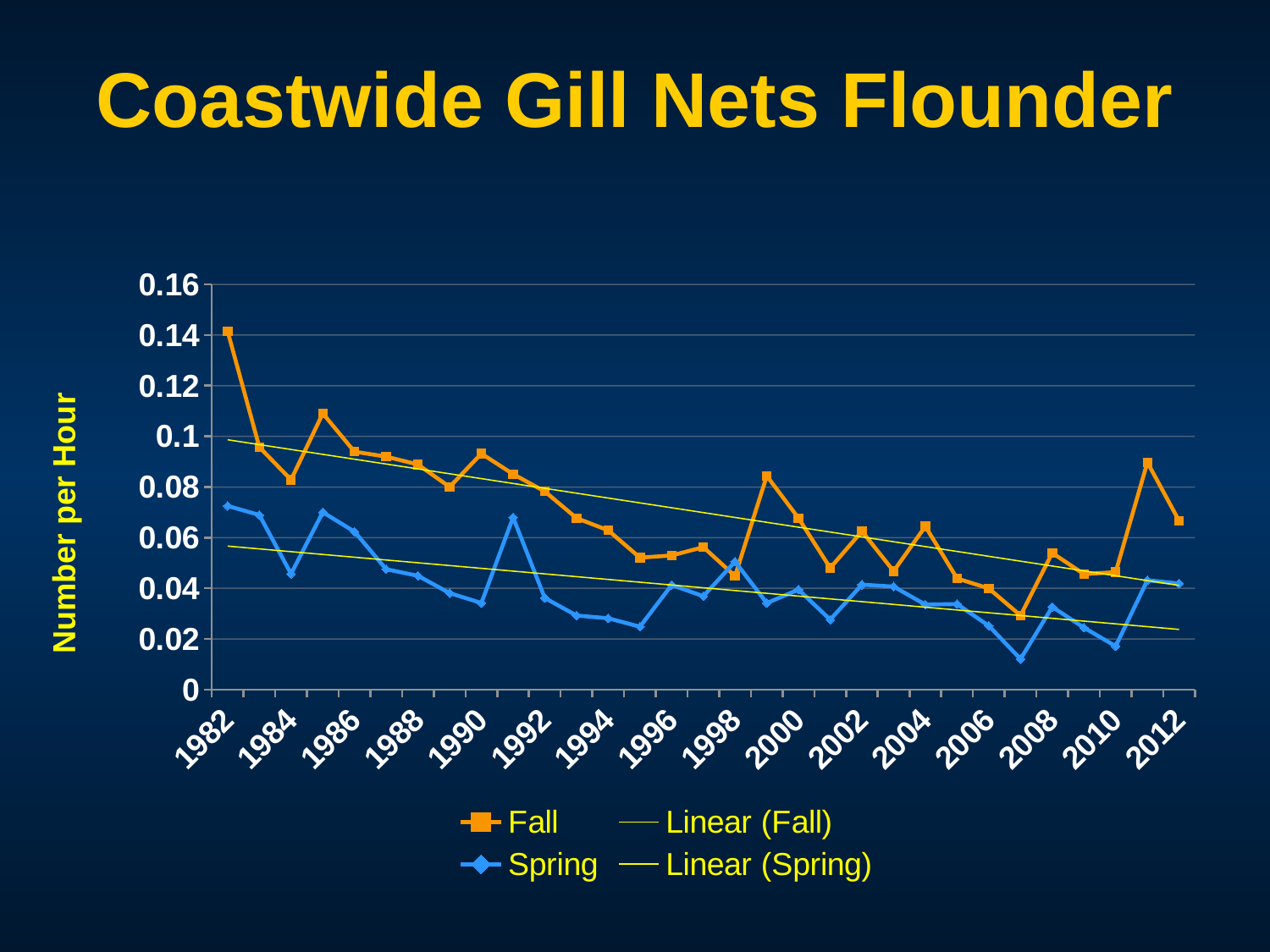
Is the Spring value for 1995 greater or less than 0.04? less What kind of chart is shown on the slide? line chart Is the Spring value for 1982 greater or less than 0.06? greater How many entries does the legend list? 4 Is the Spring value for 2007 greater or less than 0.02? less Overall, do the Fall values rise or fall from 1982 to 2012? fall In 1982, which series has the larger value, Fall or Spring? Fall In which year is the Spring series at its lowest value? 2007 What is the title of the chart? Coastwide Gill Nets Flounder In which year is the Fall series at its highest value? 1982 What is the label on the vertical axis? Number per Hour